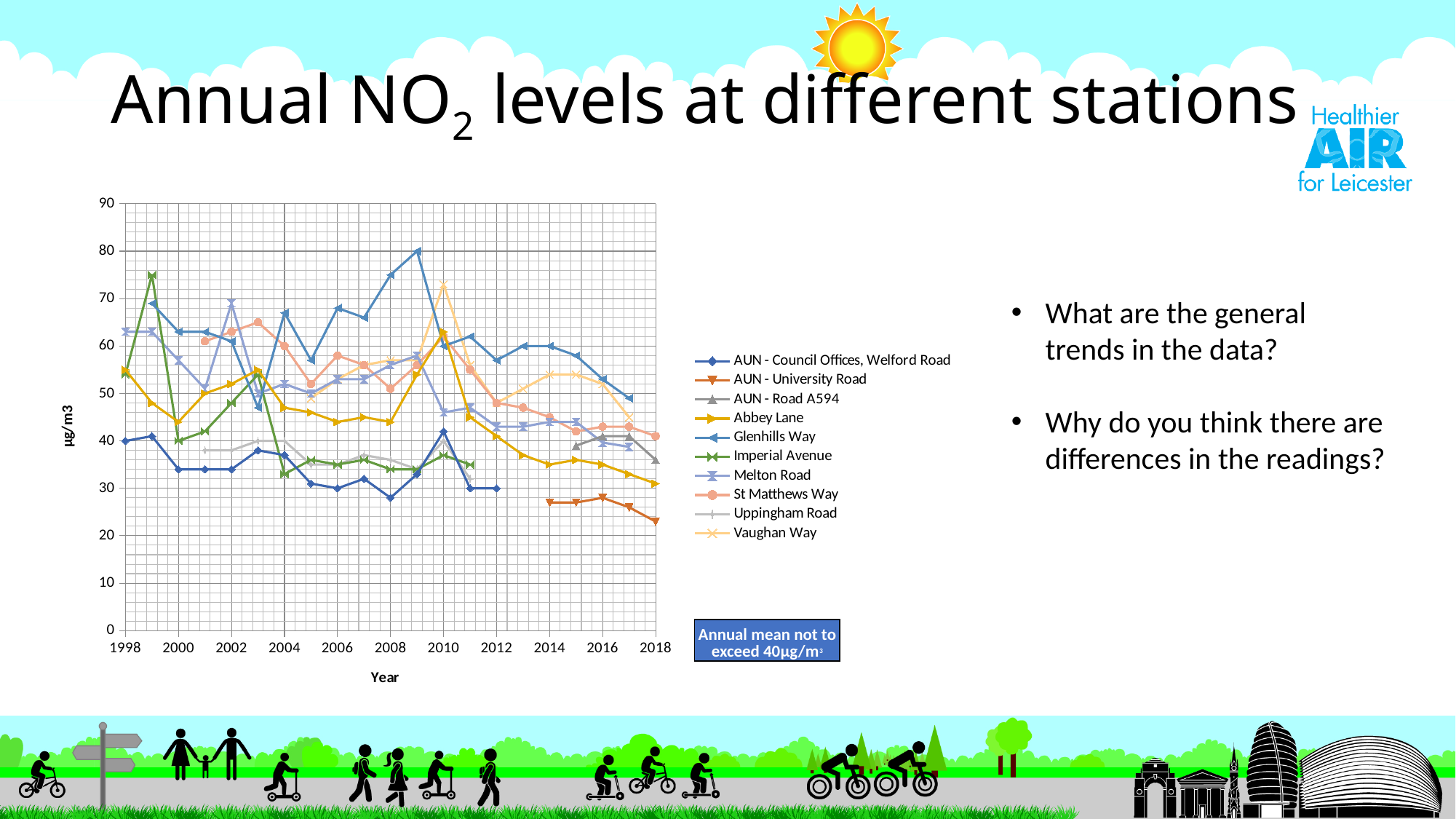
Is the value for Glenhills Way in 2009 greater or less than 70? greater Is the value for AUN - Council Offices, Welford Road in 2000 greater or less than 40? less What kind of chart is shown on the slide? line chart Is the value for AUN - University Road in 2018 greater or less than 30? less What is the label on the y axis of the chart? µg/m3 Do the values for Abbey Lane rise or fall from 2010 to 2018? fall What limit does the annotation box below the legend state for the annual mean? Annual mean not to exceed 40µg/m³ Which station reaches the highest NO2 level anywhere on the chart? Glenhills Way How many series does the chart legend list? 10